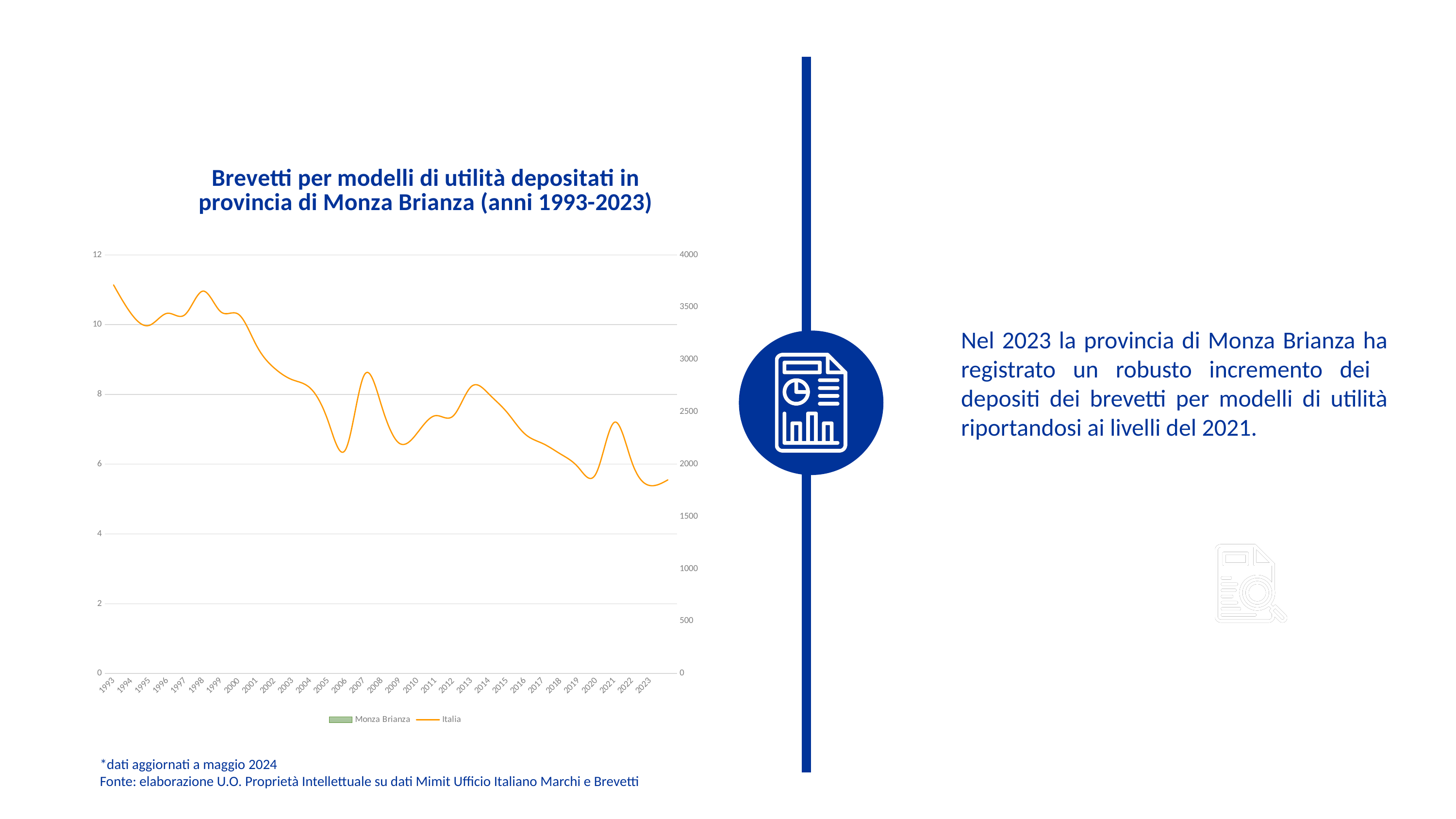
How many years are shown on the x axis? 31 Overall, does the Italia line rise or fall from 1993 to 2023? fall Which is larger for the Italia series, the value for 2021 or the value for 2020? 2021 Is the Italia value for 2013, read on the right-hand axis, greater or less than 2500? greater What is the title of the chart? Brevetti per modelli di utilità depositati in provincia di Monza Brianza (anni 1993-2023) What are the two series named in the legend? Monza Brianza and Italia What kind of chart is shown on the slide? line chart Is the Italia value for 1993, read on the right-hand axis, greater or less than 3500? greater Is the Italia value for 2023, read on the right-hand axis, greater or less than 2000? less How many series does the legend list? 2 Which is larger for the Italia series, the value for 1993 or the value for 2023? 1993